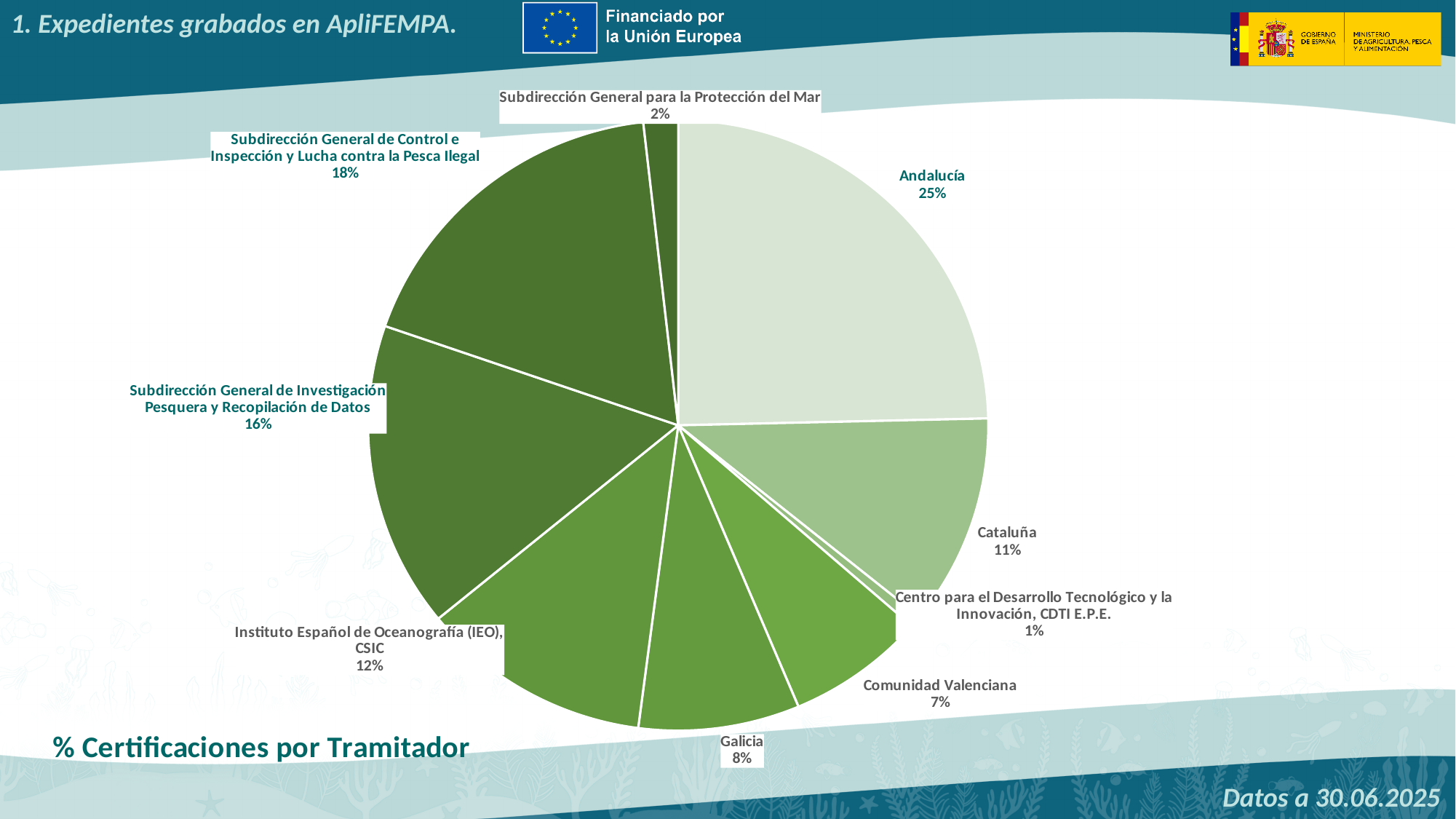
Which category has the largest slice of the pie? Andalucía What percentage is shown for Instituto Español de Oceanografía (IEO), CSIC? 12% What is the title of the chart? % Certificaciones por Tramitador What share of the pie does Andalucía have? 25% What is the difference in percentage points between Subdirección General de Control e Inspección y Lucha contra la Pesca Ilegal and Subdirección General de Investigación Pesquera y Recopilación de Datos? 2 percentage points Which is larger, the share for Comunidad Valenciana or the share for Galicia? Galicia What percentage is shown for Cataluña? 11% How many slices does the pie chart have? 9 Which category has the smallest slice of the pie? Centro para el Desarrollo Tecnológico y la Innovación, CDTI E.P.E. What percentage is shown for Subdirección General para la Protección del Mar? 2% What percentage is shown for Galicia? 8% What kind of chart is shown on the slide? Pie chart